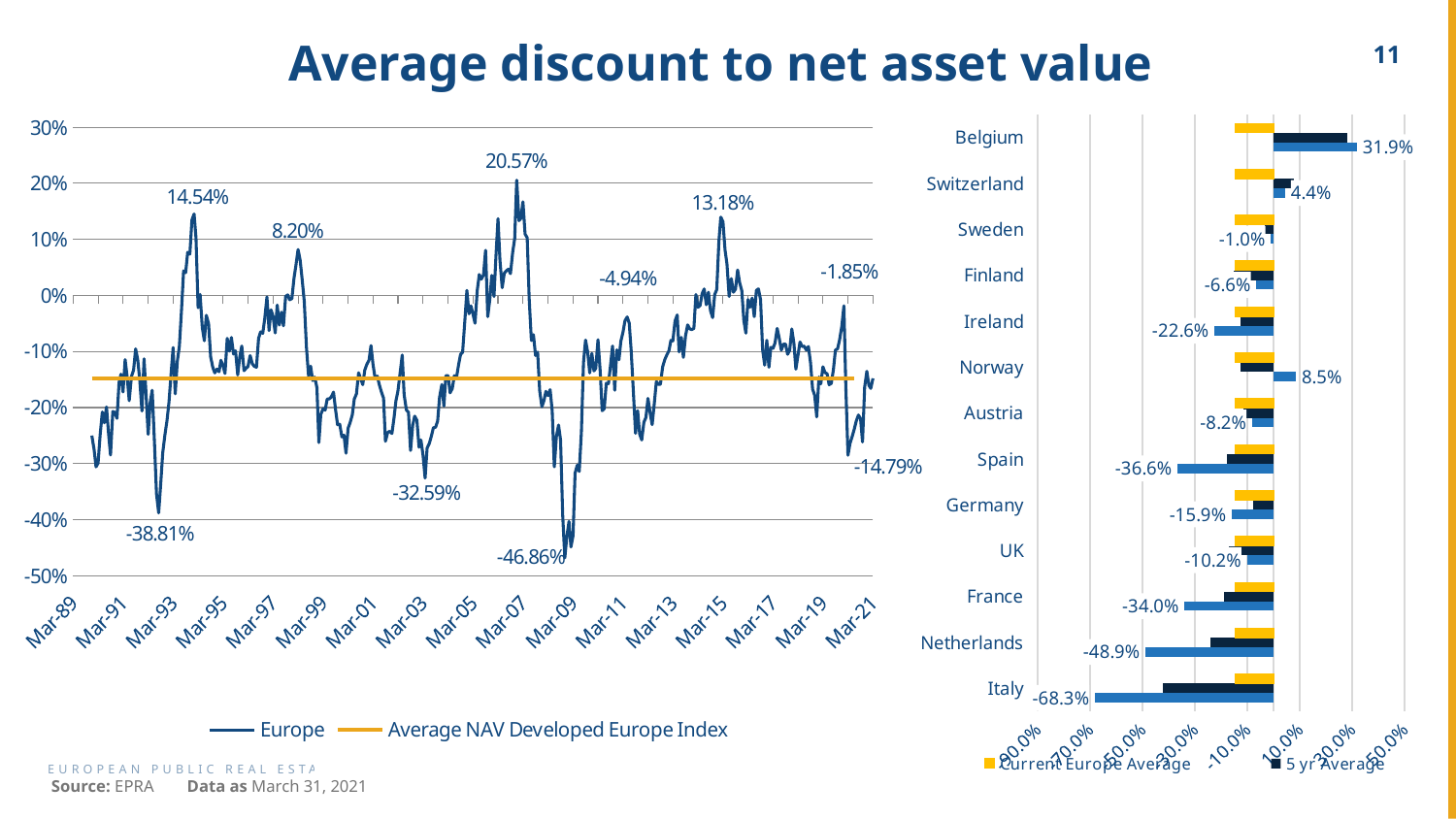
What kind of chart is the left-hand chart titled 'Average discount to net asset value'? Line chart How many countries are listed on the right-hand bar chart? 13 On the right-hand bar chart, which country has the lowest current value? Italy On the left-hand line chart, is the Average NAV Developed Europe Index line greater or less than -10%? less On the right-hand bar chart, what is the difference between the labelled values for Netherlands (-48.9%) and Italy (-68.3%)? 19.4 percentage points On the right-hand bar chart, what is the labelled value for Netherlands? -48.9% How many series does the legend of the left-hand line chart list? 2 On the right-hand bar chart, what is the labelled value for Spain? -36.6% On the left-hand line chart, what is the highest labelled value? 20.57% On the right-hand bar chart, which has the larger labelled value, France or Germany? Germany On the left-hand line chart, what is the lowest labelled value? -46.86% On the right-hand bar chart, which country has the highest current value? Belgium